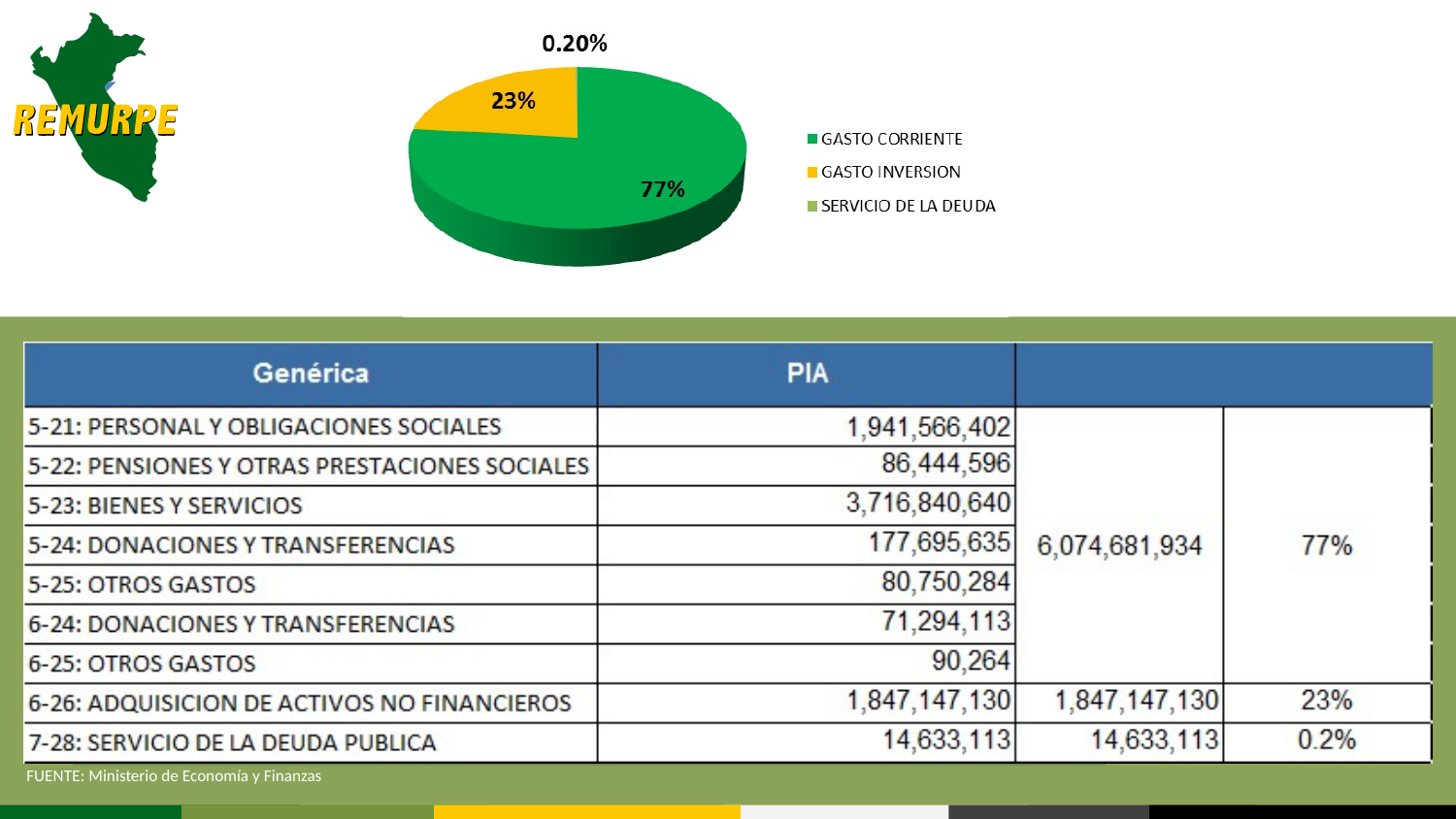
What share of the pie does GASTO CORRIENTE represent? 77% What share of the pie does SERVICIO DE LA DEUDA represent? 0.20% What colour is the GASTO CORRIENTE slice in the pie chart? green Which category has the smallest slice of the pie? SERVICIO DE LA DEUDA What is the difference in percentage points between the GASTO CORRIENTE and GASTO INVERSION slices? 54 Which is larger in the pie chart, GASTO CORRIENTE or GASTO INVERSION? GASTO CORRIENTE What colour is the GASTO INVERSION slice in the pie chart? yellow What share of the pie does GASTO INVERSION represent? 23% Which category has the largest slice of the pie? GASTO CORRIENTE What kind of chart is shown on the slide? pie chart How many slices does the pie chart have? 3 How many entries does the legend of the pie chart list? 3